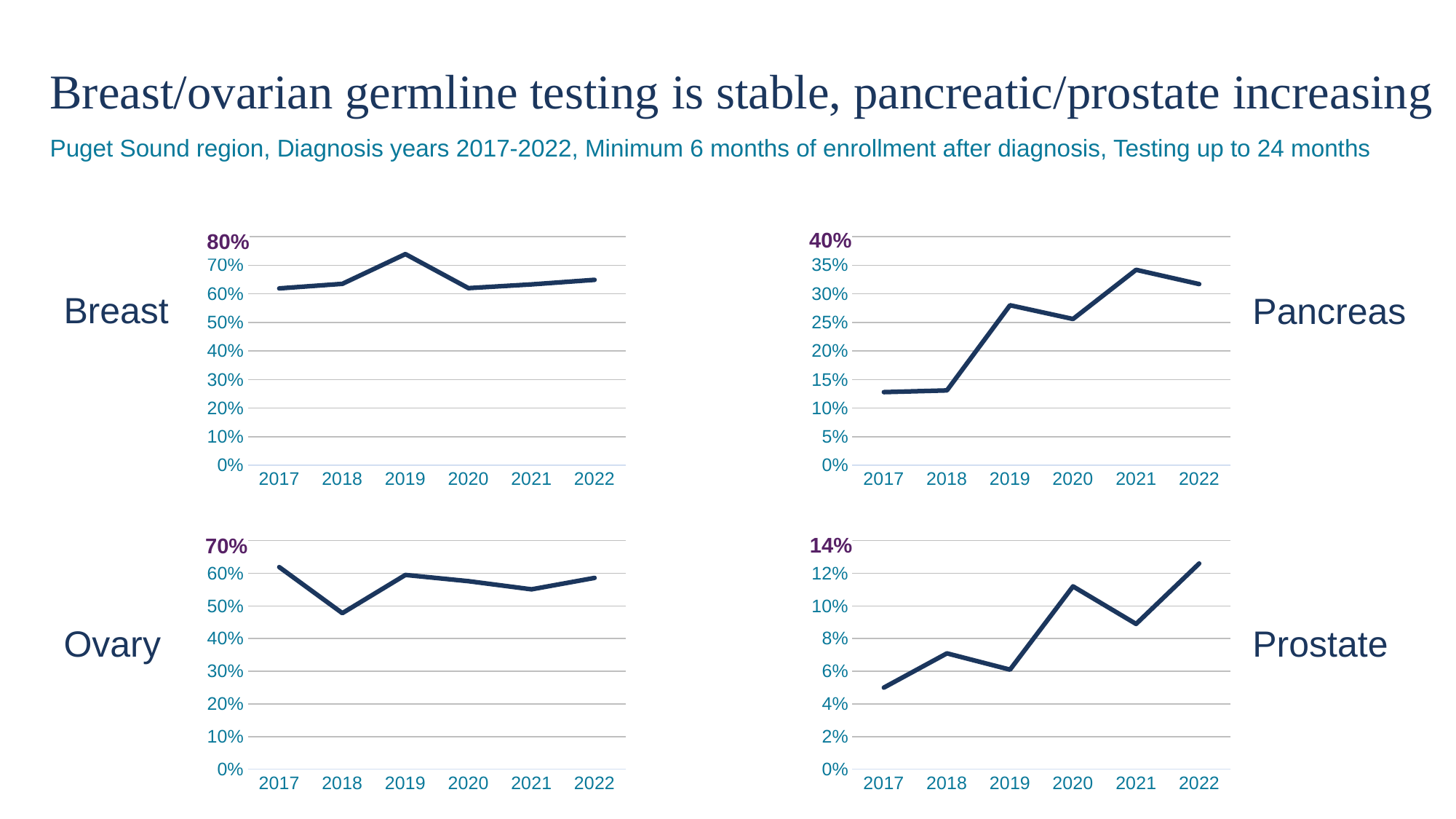
In the Ovary chart, is the value for 2018 greater or less than 50%? less What kind of chart is the Breast chart? line chart In the Prostate chart, do the values generally rise or fall from 2017 to 2022? rise In the Pancreas chart, which year has the highest value? 2021 How many years are plotted on the x axis of the Pancreas chart? 6 In the Breast chart, which year has the highest value? 2019 In the Pancreas chart, is the value for 2017 greater or less than 15%? less In the Ovary chart, which year has the lowest value? 2018 In the Breast chart, is the value for 2019 greater or less than 70%? greater In the Prostate chart, which year has the lowest value? 2017 In the Prostate chart, which year has the highest value? 2022